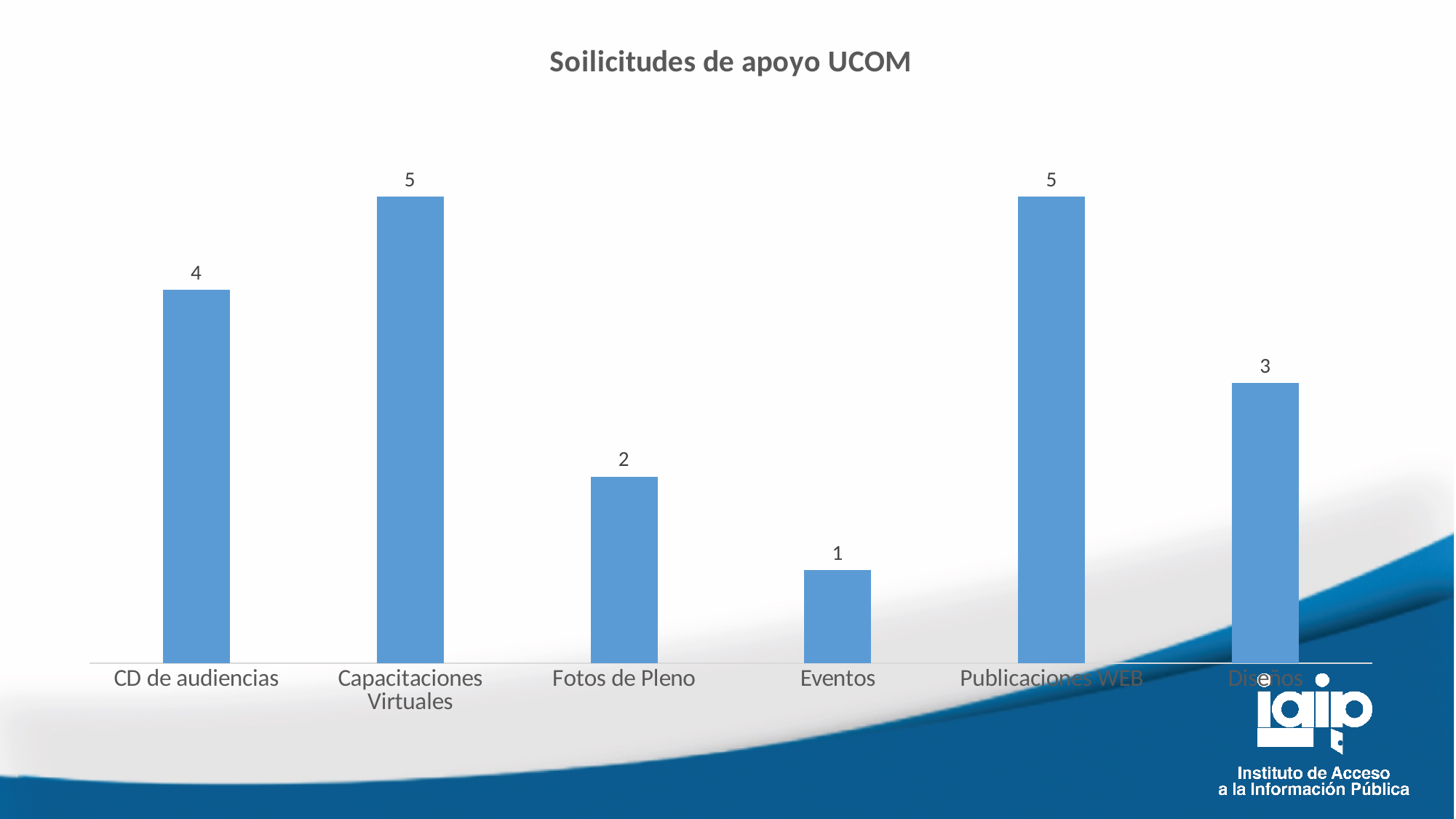
What is the difference between the values for Publicaciones WEB and Diseños? 2 What is the value for Eventos? 1 Which is larger, the value for CD de audiencias or the value for Diseños? CD de audiencias What is the value for Capacitaciones Virtuales? 5 What is the value for CD de audiencias? 4 What is the title of the chart? Soilicitudes de apoyo UCOM Which category has the lowest value? Eventos What is the difference between the values for CD de audiencias and Fotos de Pleno? 2 What kind of chart is shown on the slide? Bar chart What is the value for Fotos de Pleno? 2 What is the value for Diseños? 3 How many categories are shown in the chart? 6